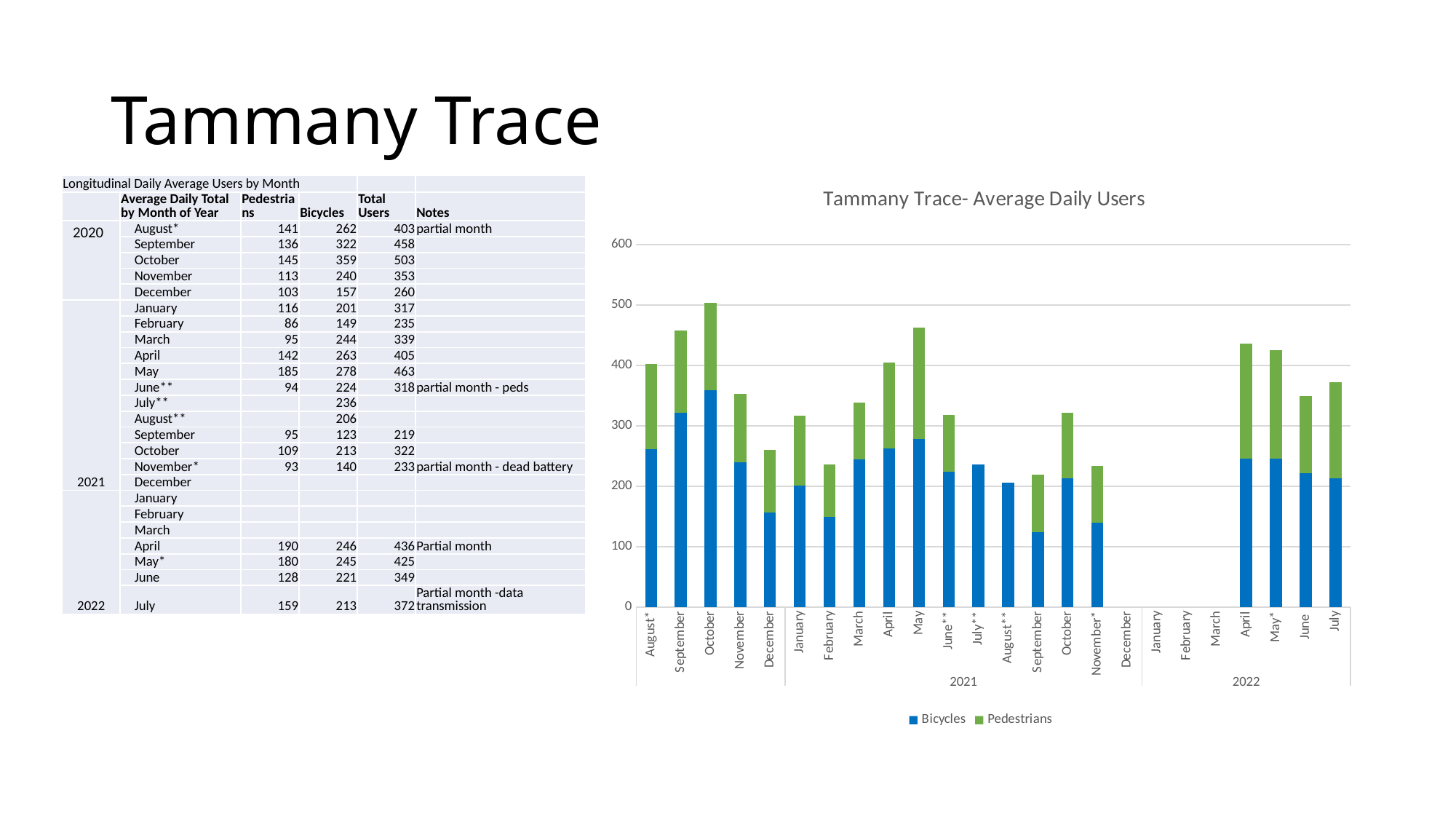
What is the difference between the total users for October 2020 and September 2020? 45 Which has the larger total bar, May 2021 or April 2022? May 2021 What is the total of the stacked bar for May 2021? 463 What is the Bicycles value for October 2020? 359 What are the two series named in the chart legend? Bicycles and Pedestrians Which month in 2020 has the shortest stacked bar? December How many series does the chart legend list? 2 What kind of chart is shown on the slide? bar chart What is the title of the chart? Tammany Trace- Average Daily Users What is the Pedestrians value for May 2021? 185 Is the total bar for February 2021 greater or less than 300? less Which month has the tallest stacked bar in the chart? October 2020